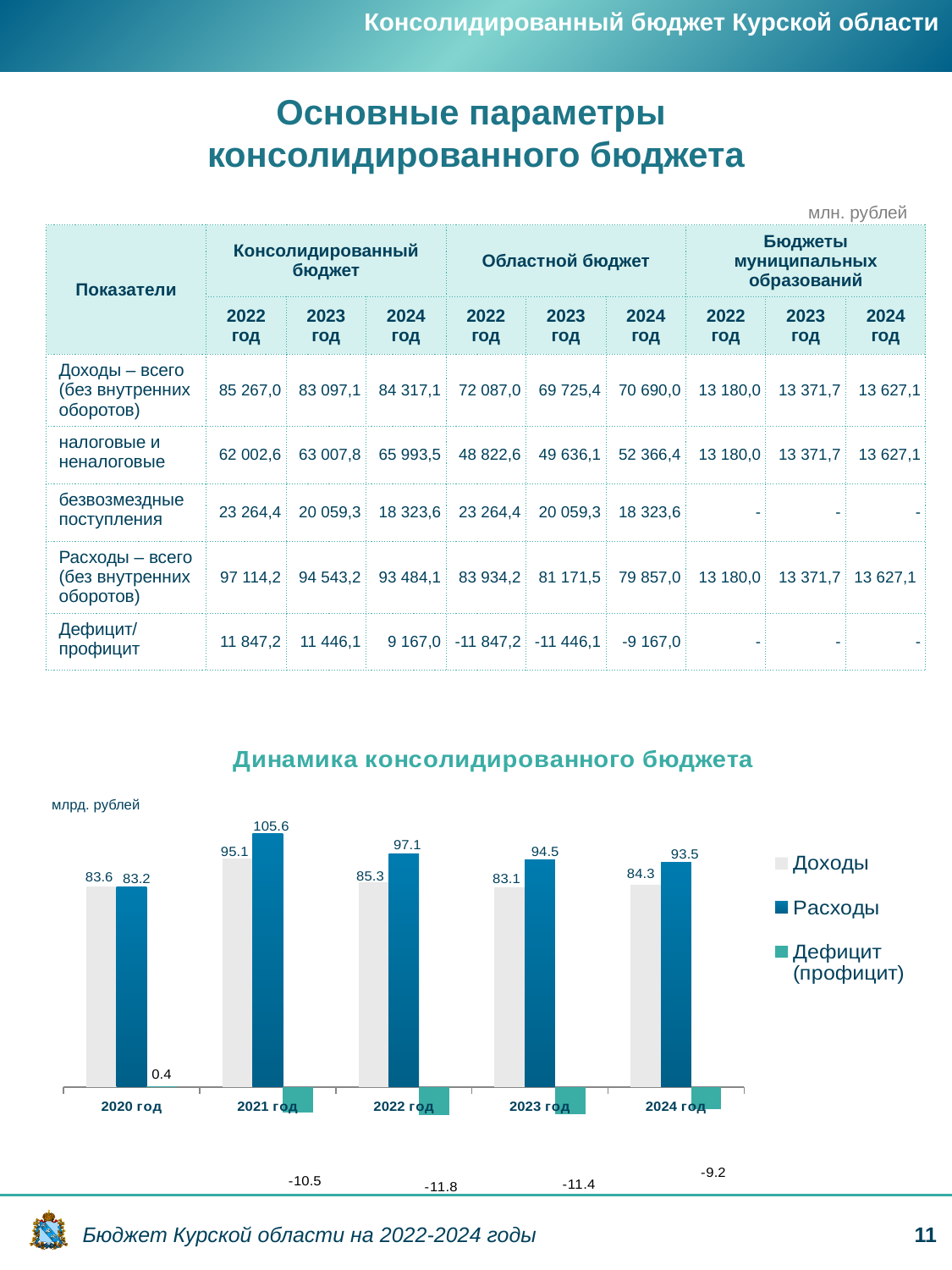
In the chart 'Динамика консолидированного бюджета', which year has the lowest value of Доходы? 2023 год In the chart 'Динамика консолидированного бюджета', how many series does the legend list? 3 In the chart 'Динамика консолидированного бюджета', what is the value of Доходы for 2024 год? 84.3 In the chart 'Динамика консолидированного бюджета', what unit is stated above the chart? млрд. рублей In the chart 'Динамика консолидированного бюджета', what is the difference between Расходы and Доходы for 2023 год? 11.4 In the chart 'Динамика консолидированного бюджета', do the values of Расходы rise or fall from 2021 год to 2024 год? fall In the chart 'Динамика консолидированного бюджета', how many years are shown on the x axis? 5 In the chart 'Динамика консолидированного бюджета', which is larger for 2020 год: Доходы or Расходы? Доходы What type of chart is 'Динамика консолидированного бюджета'? bar chart In the chart 'Динамика консолидированного бюджета', which year has the highest value of Расходы? 2021 год In the chart 'Динамика консолидированного бюджета', what is the value of Дефицит (профицит) for 2022 год? -11.8 In the chart 'Динамика консолидированного бюджета', what is the value of Расходы for 2021 год? 105.6